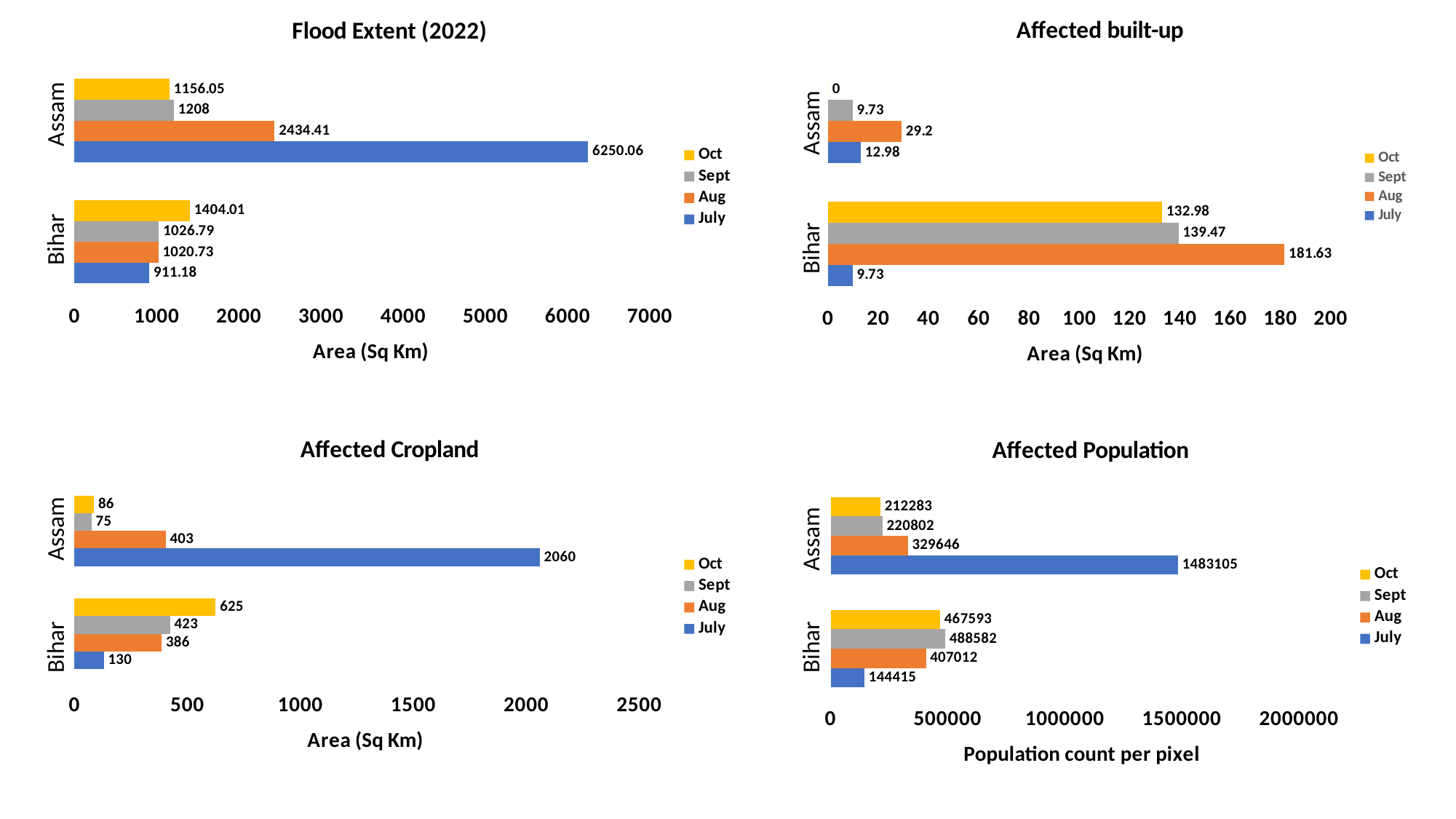
In the Affected Cropland chart, which month has the highest value for Assam? July In the Affected Cropland chart, which month has the lowest value for Bihar? July How many series does the legend of the Affected Population chart list? 4 In the Flood Extent (2022) chart, what is the value for Assam in July? 6250.06 In the Flood Extent (2022) chart, which is larger: Assam in Aug or Bihar in Aug? Assam in Aug In the Affected Cropland chart, what is the difference between Bihar's Oct and Sept values? 202 In the Affected built-up chart, what is the value for Bihar in Aug? 181.63 In the Affected Population chart, what is the value for Assam in July? 1483105 What kind of chart is the Affected built-up chart? Bar chart In the Flood Extent (2022) chart, what is the value for Bihar in Oct? 1404.01 In the Affected Population chart, what is the difference between Bihar's Sept and Oct values? 20989 In the Affected built-up chart, what is the value for Assam in Oct? 0